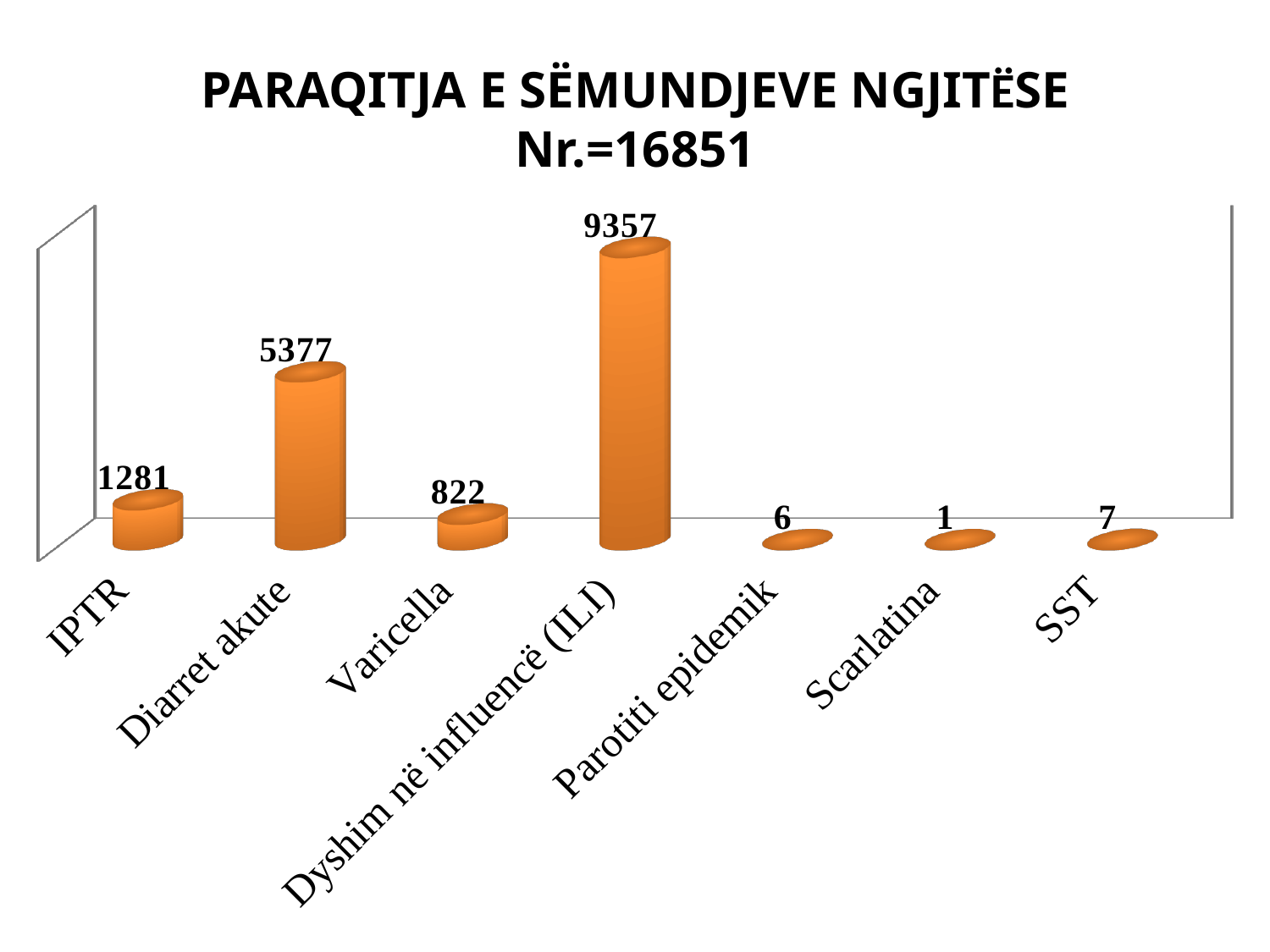
What is the difference between the values for IPTR and Varicella? 459 Which category has the lowest value? Scarlatina What is the value for Varicella? 822 What is the difference between the values for Dyshim në influencë (ILI) and Diarret akute? 3980 What is the value for Dyshim në influencë (ILI)? 9357 Which is larger, the value for IPTR or the value for Varicella? IPTR Which category has the highest value? Dyshim në influencë (ILI) What is the value for Scarlatina? 1 What is the title of the chart? PARAQITJA E SËMUNDJEVE NGJITËSE Nr.=16851 What kind of chart is shown on the slide? Bar chart How many categories are shown on the chart? 7 What is the value for Diarret akute? 5377